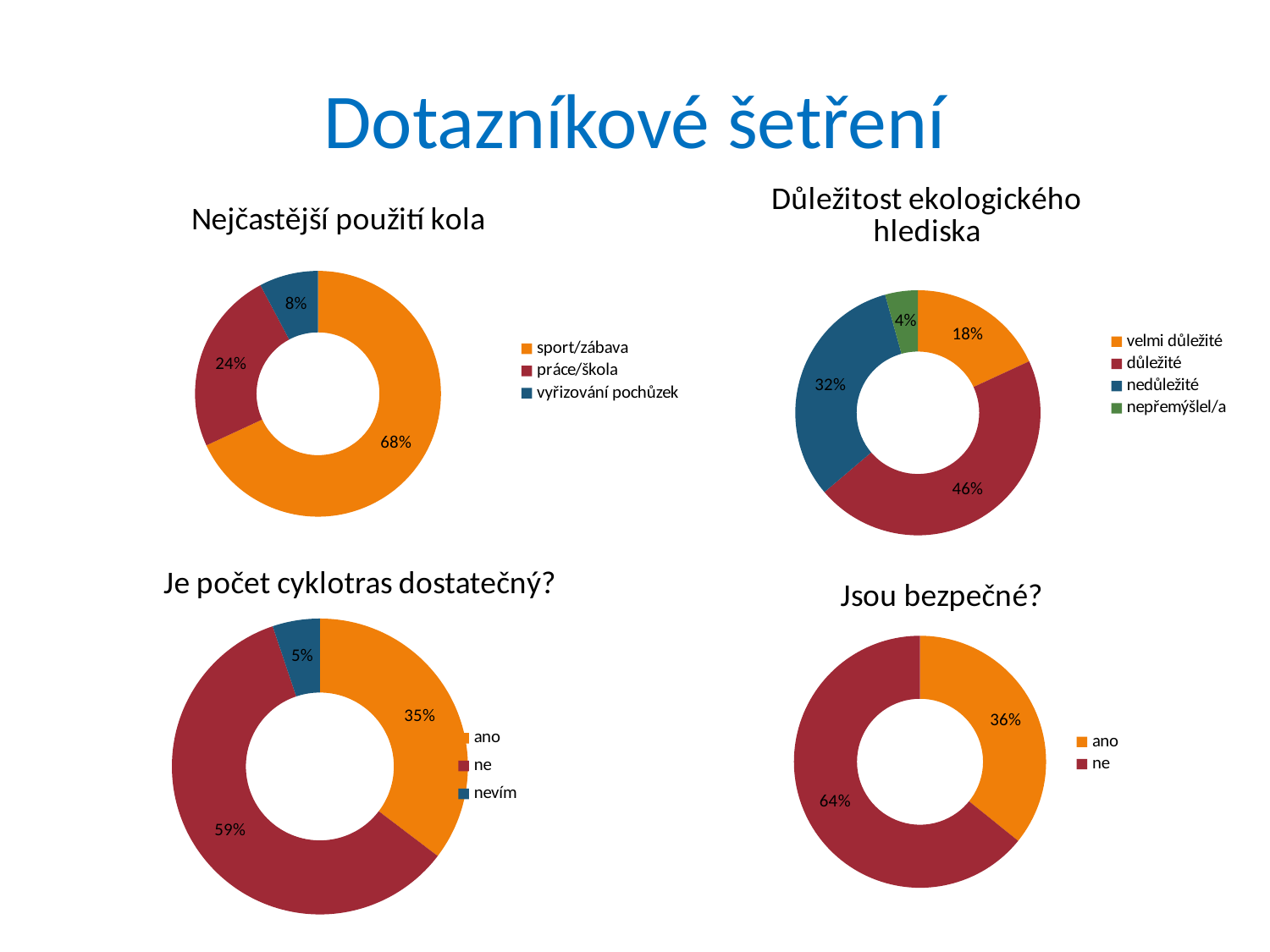
In the chart titled "Důležitost ekologického hlediska", which is larger: velmi důležité or nepřemýšlel/a? velmi důležité In the chart titled "Nejčastější použití kola", which category has the smallest share? vyřizování pochůzek In the chart titled "Důležitost ekologického hlediska", which category has the largest share? důležité In the chart titled "Důležitost ekologického hlediska", how many categories does the legend list? 4 In the chart titled "Důležitost ekologického hlediska", what is the share for nedůležité? 32% What type of chart is used for "Jsou bezpečné?"? Doughnut (pie) chart In the chart titled "Jsou bezpečné?", what is the share for ano? 36% In the chart titled "Jsou bezpečné?", which category has the larger share? ne In the chart titled "Je počet cyklotras dostatečný?", what is the share for ne? 59% In the chart titled "Nejčastější použití kola", what is the share for sport/zábava? 68% In the chart titled "Nejčastější použití kola", what is the difference between the shares for sport/zábava and práce/škola? 44 percentage points In the chart titled "Je počet cyklotras dostatečný?", what is the difference between the shares for ne and ano? 24 percentage points